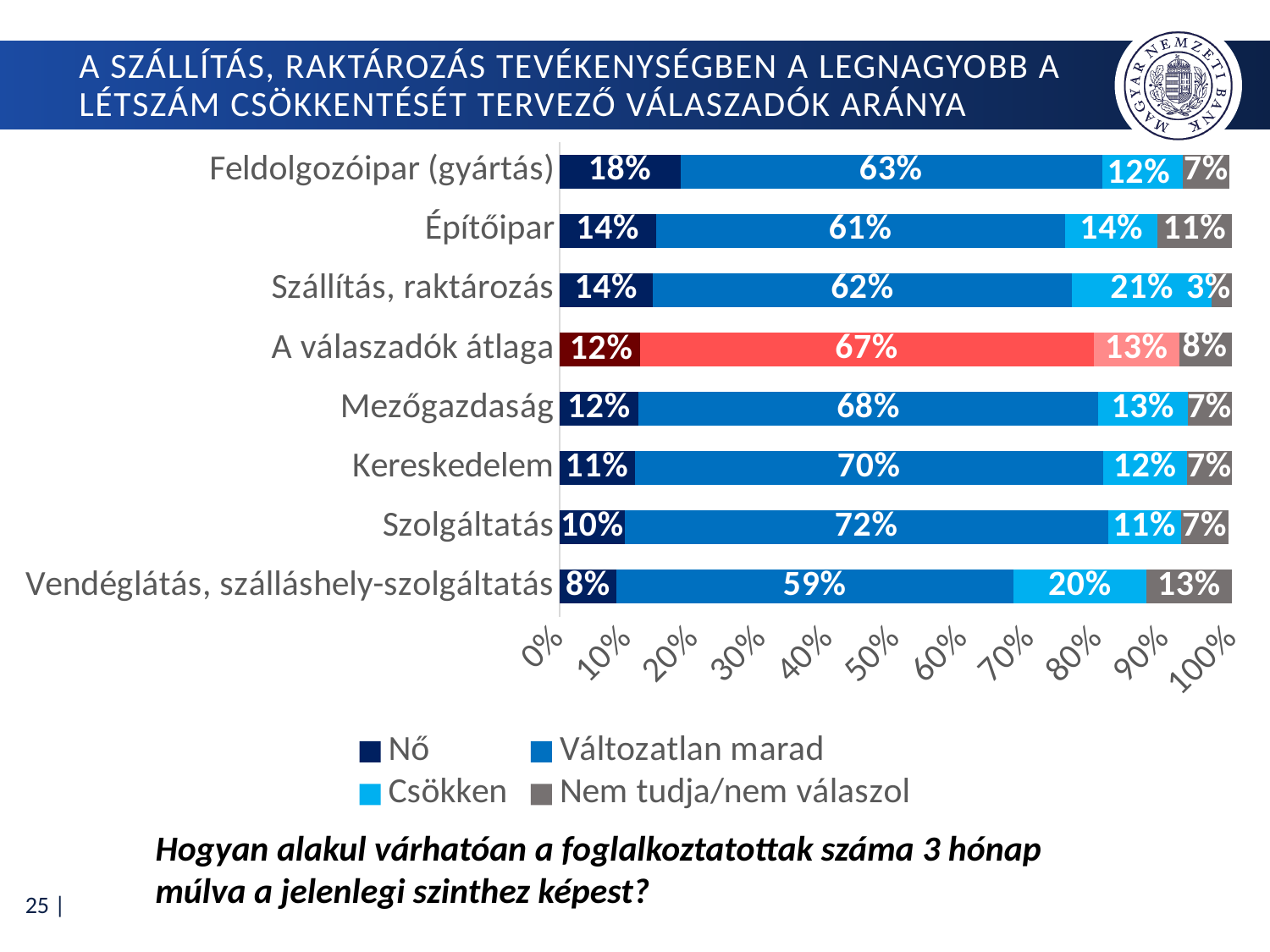
How many categories are shown on the chart? 8 What is the 'Nem tudja/nem válaszol' value for Vendéglátás, szálláshely-szolgáltatás? 13% Which category has the lowest 'Nő' share? Vendéglátás, szálláshely-szolgáltatás Which has a larger 'Nem tudja/nem válaszol' share, Építőipar or Szállítás, raktározás? Építőipar What percentage of respondents in Szállítás, raktározás expect headcount to decrease (Csökken)? 21% What is the total of the stacked bar for Mezőgazdaság? 100% What is the 'Nő' value for Feldolgozóipar (gyártás)? 18% What kind of chart is shown on the slide? Stacked bar chart Which category has the highest 'Csökken' share? Szállítás, raktározás How many series does the legend list? 4 What is the 'Változatlan marad' value for Szolgáltatás? 72% What is the difference between the 'Változatlan marad' values for Szolgáltatás and Vendéglátás, szálláshely-szolgáltatás? 13 percentage points